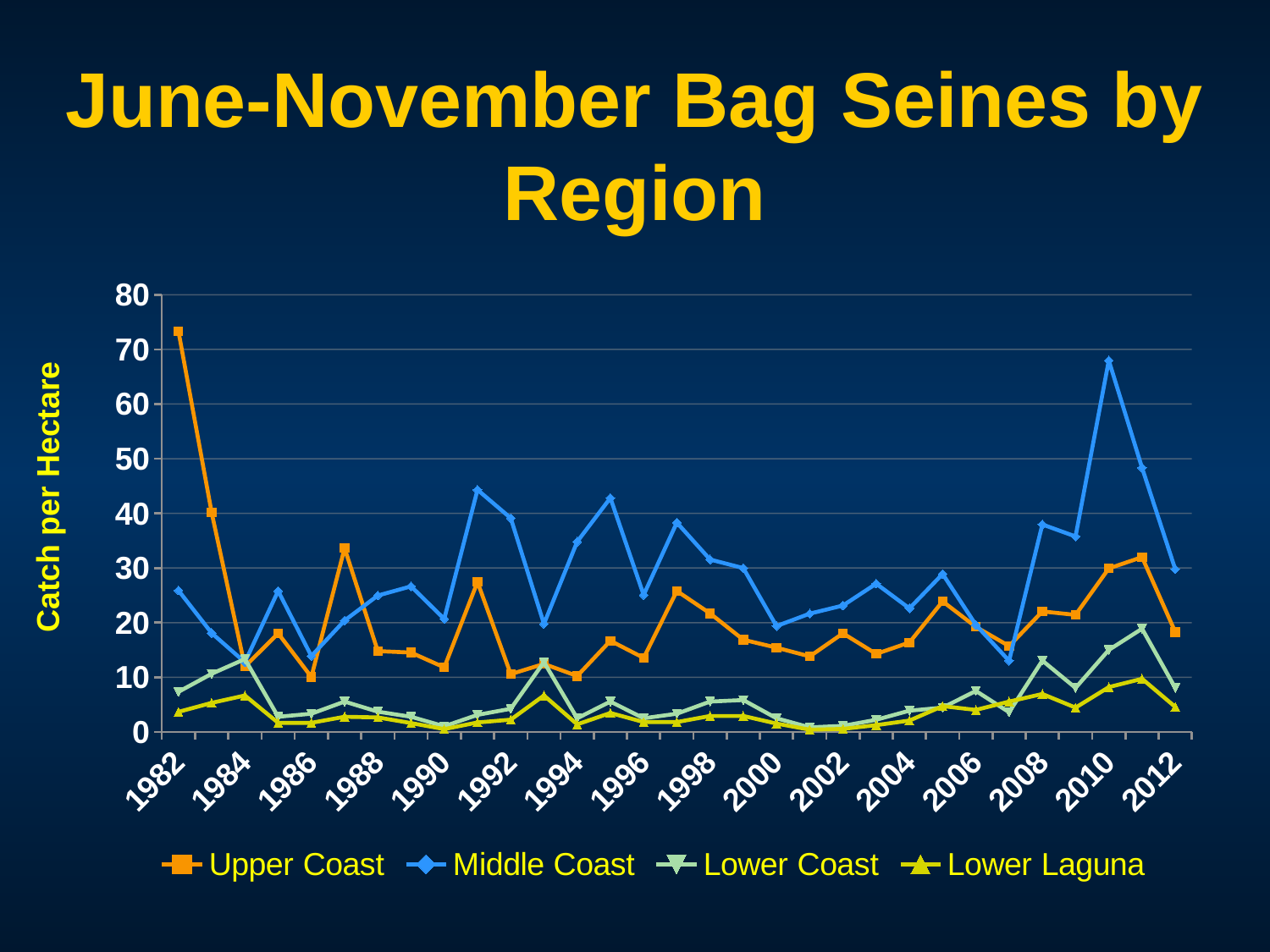
Does the Upper Coast series rise or fall from 1982 to 1984? fall How many series does the legend list? 4 In 1982, which is larger: Upper Coast or Middle Coast? Upper Coast What are the four series named in the legend? Upper Coast, Middle Coast, Lower Coast, Lower Laguna Is the value for Upper Coast in 1982 greater or less than 70? greater What is the title of the vertical axis? Catch per Hectare In which year does the Middle Coast series reach its highest value? 2010 Is the value for Middle Coast in 2012 greater or less than 20? greater In which year does the Upper Coast series reach its highest value? 1982 Is the value for Middle Coast in 2010 greater or less than 60? greater What kind of chart is shown on the slide? line chart In 2010, which is larger: Middle Coast or Upper Coast? Middle Coast